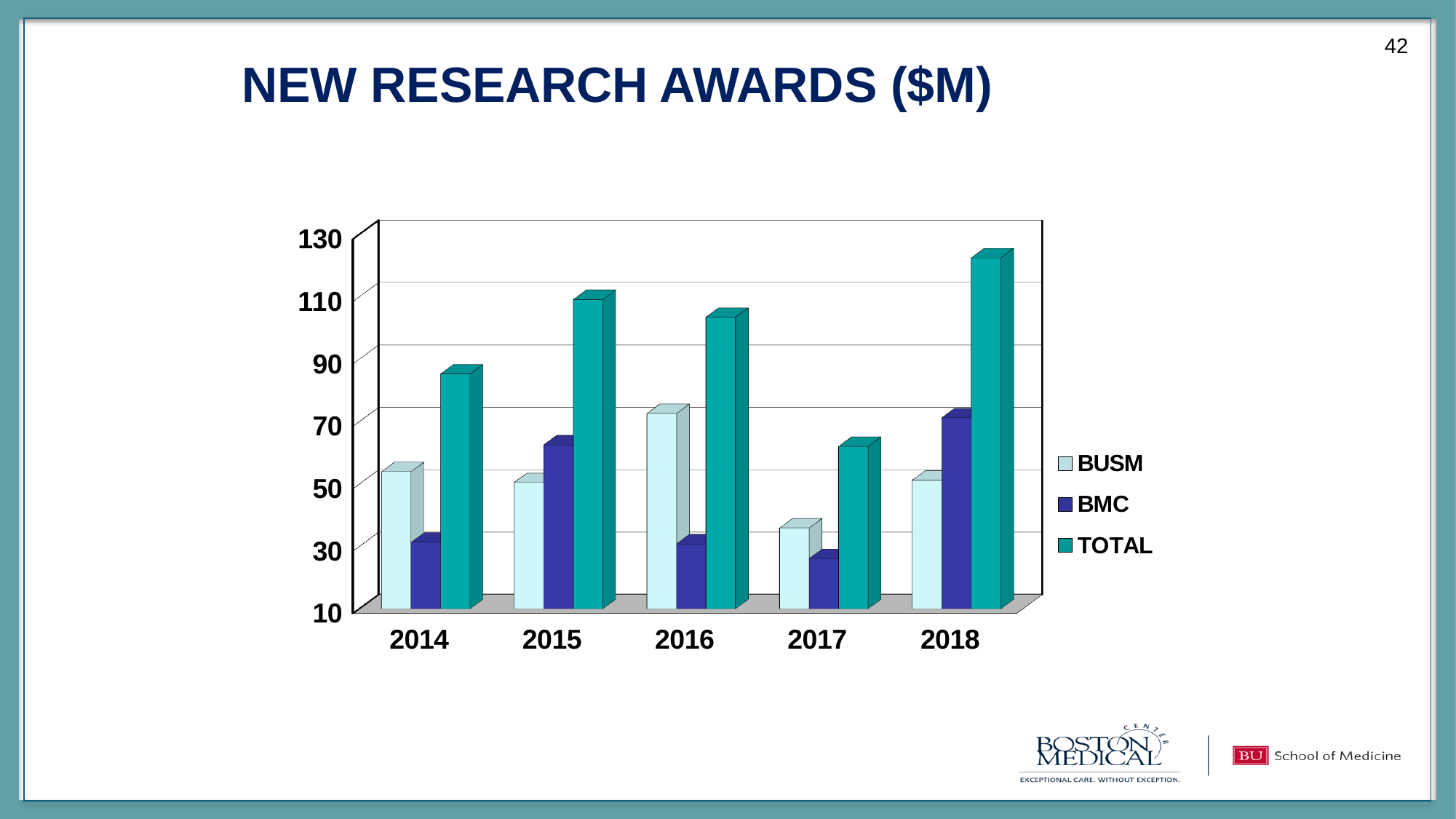
In which year is the BMC bar lowest? 2017 How many series does the legend list? 3 In 2015, which is larger, BUSM or BMC? BMC What kind of chart is shown on the slide? bar chart In which year is the TOTAL bar lowest? 2017 How many years are shown on the x axis? 5 In which year is the BUSM bar highest? 2016 In 2014, which is larger, BUSM or BMC? BUSM Is the TOTAL value for 2018 greater or less than 110? greater In which year is the TOTAL bar highest? 2018 What is the title of the chart? NEW RESEARCH AWARDS ($M) Is the TOTAL value for 2017 greater or less than 70? less